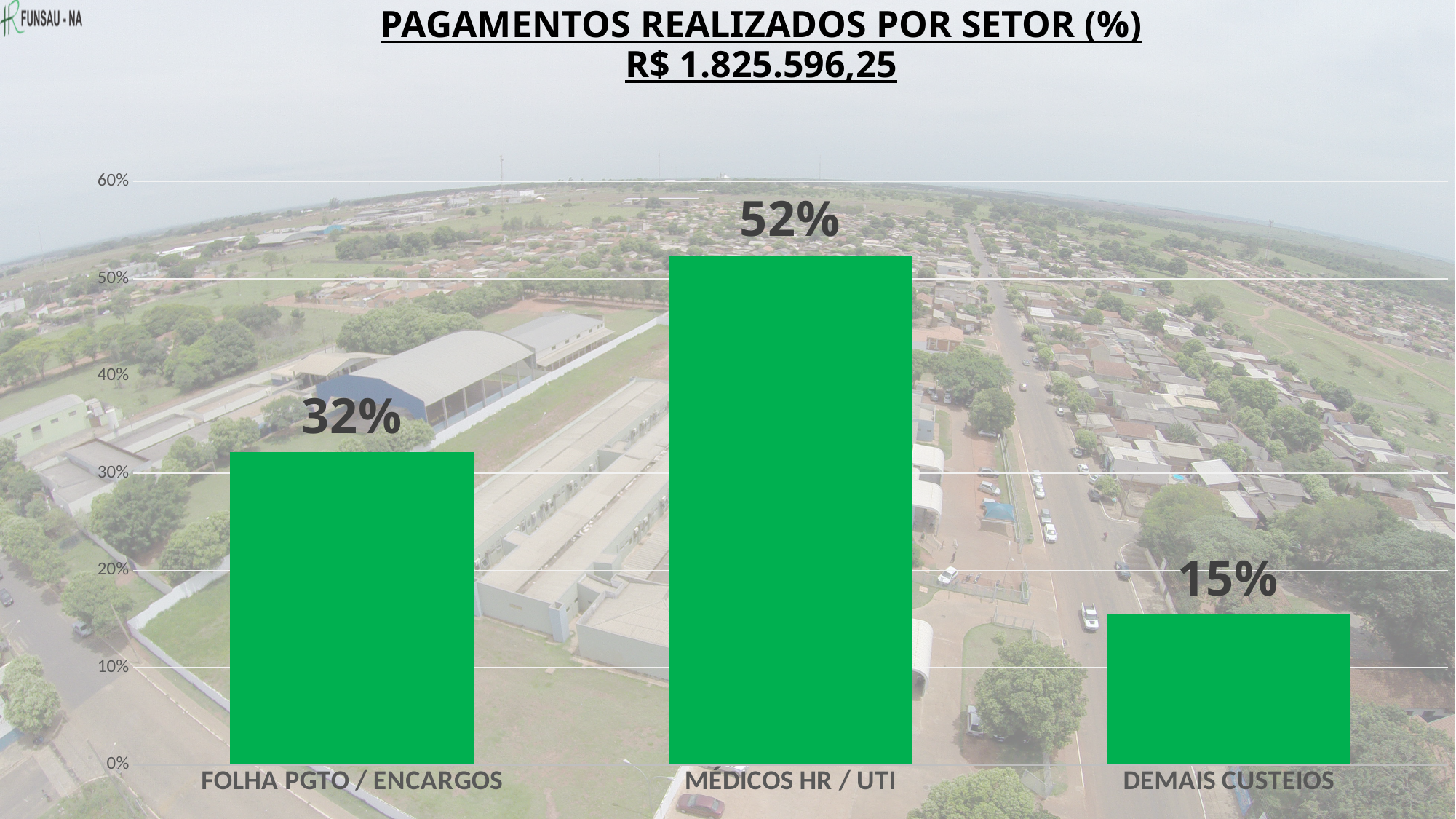
How many categories are shown in the chart? 3 Which category has the lowest value? DEMAIS CUSTEIOS Is the value for MÉDICOS HR / UTI greater or less than 50%? greater What total amount is shown in the chart title? R$ 1.825.596,25 Which is larger, the value for FOLHA PGTO / ENCARGOS or the value for DEMAIS CUSTEIOS? FOLHA PGTO / ENCARGOS Which category has the highest value? MÉDICOS HR / UTI What is the difference between the values for FOLHA PGTO / ENCARGOS and DEMAIS CUSTEIOS? 17% What is the value for DEMAIS CUSTEIOS? 15% What is the difference between the values for MÉDICOS HR / UTI and FOLHA PGTO / ENCARGOS? 20% What is the value for MÉDICOS HR / UTI? 52% What kind of chart is shown on the slide? bar chart What is the value for FOLHA PGTO / ENCARGOS? 32%